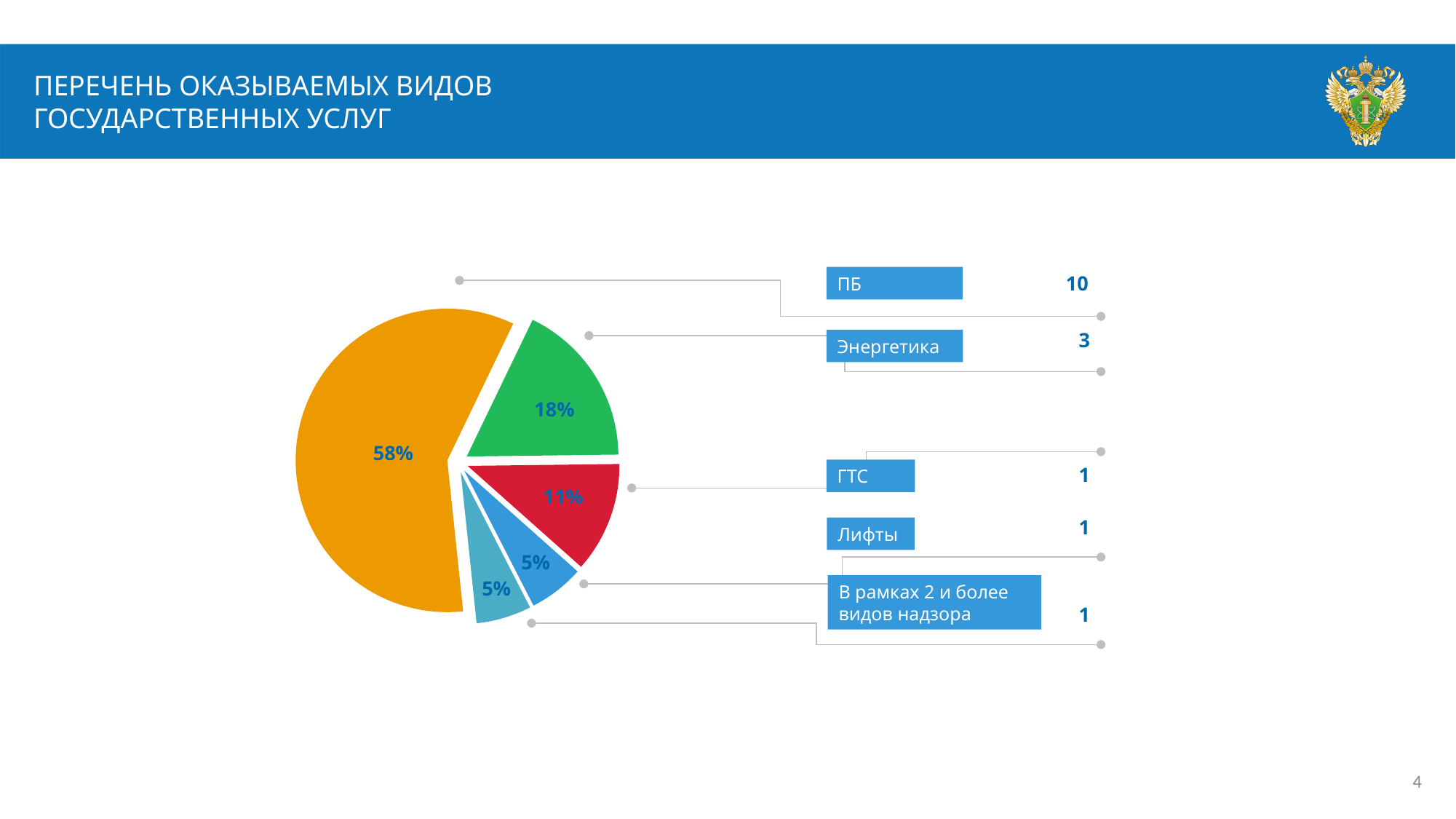
What number is shown next to the Энергетика label? 3 What colour is the largest slice of the pie? orange What kind of chart is shown on the slide? pie chart What share of the pie does the ГТС slice represent? 11% What share of the pie does the Энергетика slice represent? 18% What share of the pie does the ПБ slice represent? 58% Which slice is larger, Энергетика or ГТС? Энергетика What number is shown next to the ПБ label? 10 What is the difference in percentage points between the ПБ slice and the Энергетика slice? 40 Which category has the largest slice of the pie? ПБ What number is shown next to the ГТС label? 1 How many slices does the pie chart have? 5